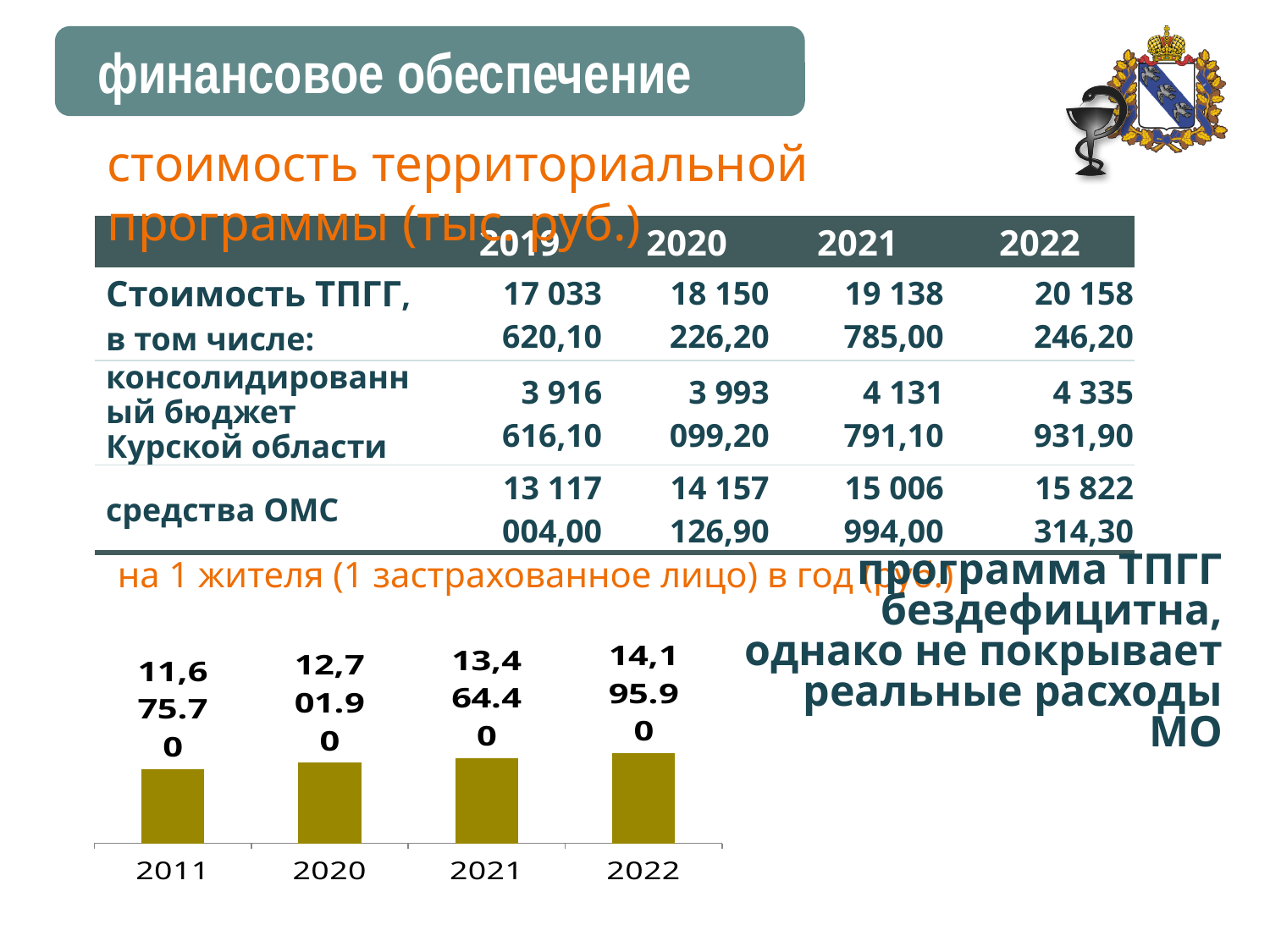
In the bar chart at the bottom of the slide, what is the value for 2020? 12,701.90 In the bar chart at the bottom of the slide, what is the value for 2021? 13,464.40 In the bar chart at the bottom of the slide, which category has the highest value? 2022 In the bar chart at the bottom of the slide, which is larger: the value for 2020 or the value for 2021? 2021 In the bar chart at the bottom of the slide, what is the value for 2011? 11,675.70 What type of chart is shown at the bottom of the slide? bar chart In the bar chart at the bottom of the slide, what is the value for 2022? 14,195.90 How many bars (categories) does the bar chart at the bottom of the slide have? 4 In the bar chart at the bottom of the slide, do the values rise or fall from left to right along the x axis? rise In the bar chart at the bottom of the slide, which category has the lowest value? 2011 In the bar chart at the bottom of the slide, what is the difference between the values for 2021 and 2020? 762.50 In the bar chart at the bottom of the slide, what is the difference between the values for 2022 and 2011? 2,520.20